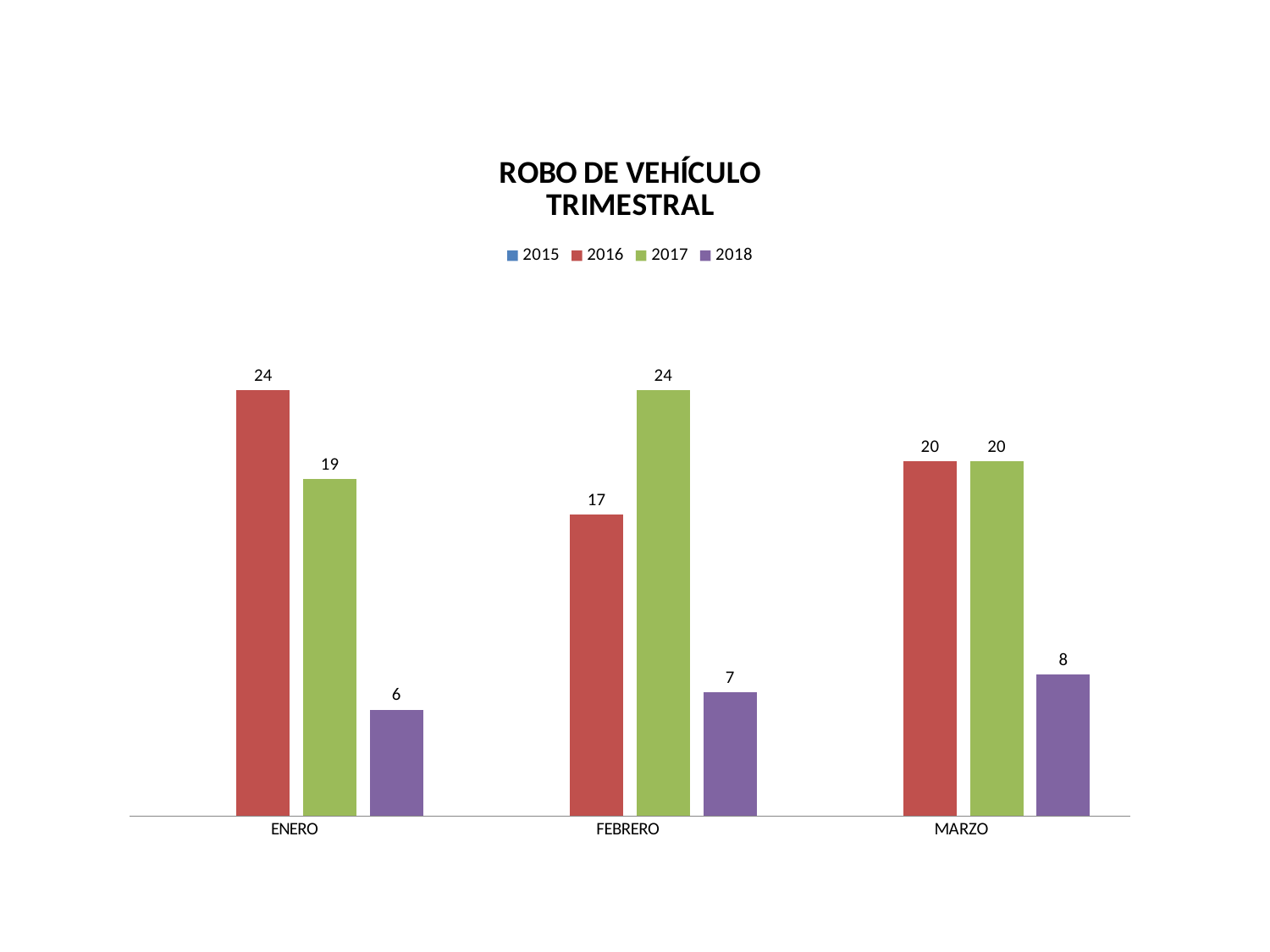
What is the value for 2017 in FEBRERO? 24 What is the value for 2016 in ENERO? 24 Which month has the highest value for the 2017 series? FEBRERO How many months are shown on the x axis? 3 What is the value for 2016 in FEBRERO? 17 Which month has the lowest value for the 2018 series? ENERO What is the difference between the 2016 and 2017 values in ENERO? 5 What is the value for 2018 in MARZO? 8 Which is larger in FEBRERO, the 2016 value or the 2017 value? 2017 What kind of chart is shown on the slide? Bar chart What is the title of the chart? ROBO DE VEHÍCULO TRIMESTRAL How many series does the legend list? 4